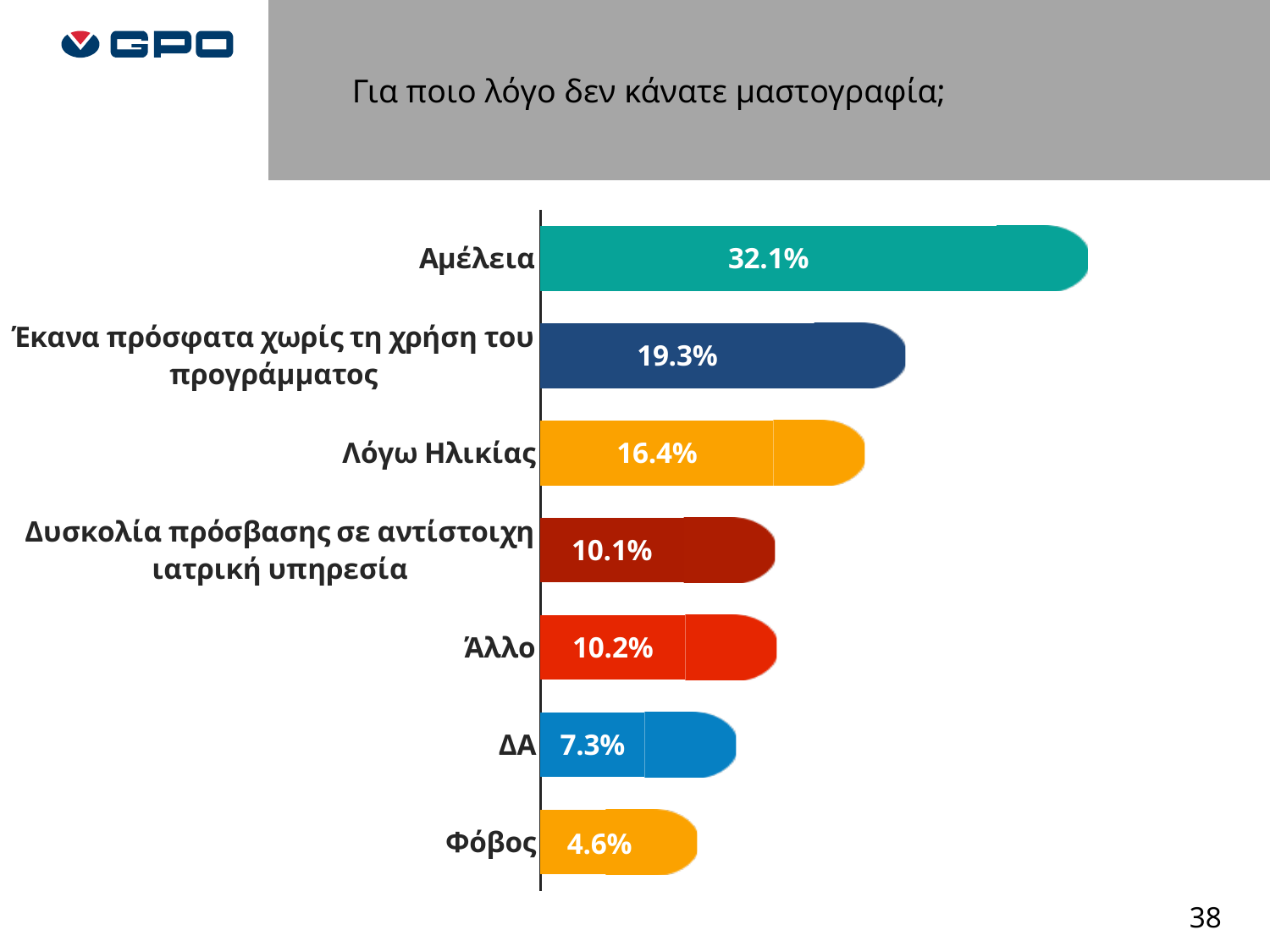
What is the value for ΔΑ? 7.3% What is the value for Φόβος? 4.6% What is the difference between the values for Λόγω Ηλικίας and Φόβος? 11.8% Which category has the lowest value? Φόβος What percentage is shown for Λόγω Ηλικίας? 16.4% What kind of chart is shown on the slide? Bar chart Which category has the highest value? Αμέλεια How many categories are shown in the chart? 7 What is the difference between the values for Αμέλεια and Έκανα πρόσφατα χωρίς τη χρήση του προγράμματος? 12.8% What percentage is shown for Αμέλεια? 32.1% Which is larger, the value for Λόγω Ηλικίας or the value for ΔΑ? Λόγω Ηλικίας What is the title of the slide? Για ποιο λόγο δεν κάνατε μαστογραφία;